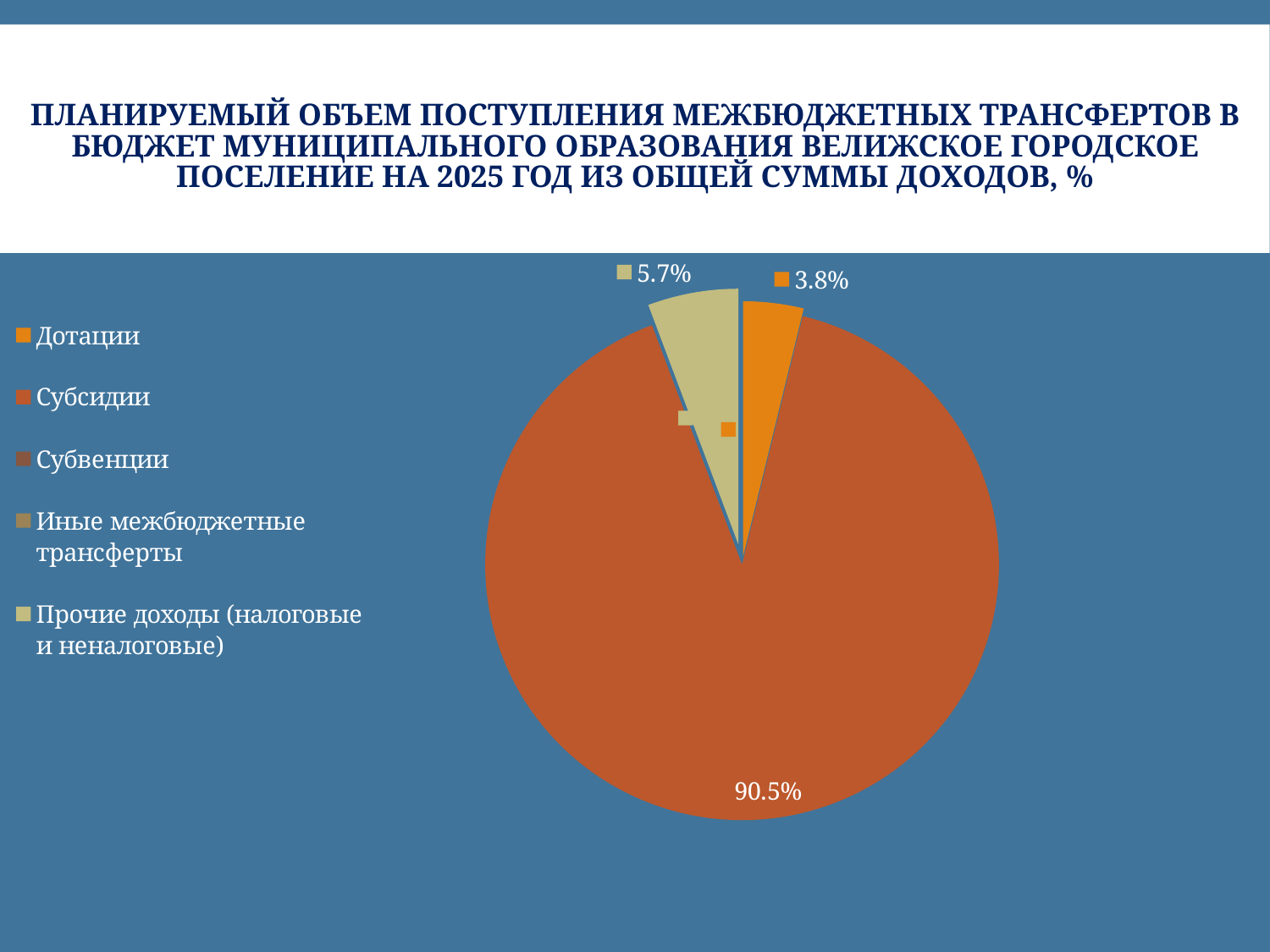
What type of chart is shown on the slide? Pie chart By how many percentage points does the slice labelled 5.7% exceed the Дотации slice? 1.9 Is the share for Субсидии greater or less than 50%? greater By how many percentage points does the Субсидии slice exceed the Дотации slice? 86.7 Which category has the largest slice of the pie? Субсидии What share of the pie is labelled for Субсидии? 90.5% Which is larger, the slice for Дотации or the slice for Субсидии? Субсидии What share of the pie is labelled for Дотации? 3.8% How many slices of the pie have a percentage data label printed? 3 For which year does the chart title say the intergovernmental transfers are planned? 2025 How many entries does the legend of the pie chart list? 5 On which side of the pie chart is the legend placed? Left